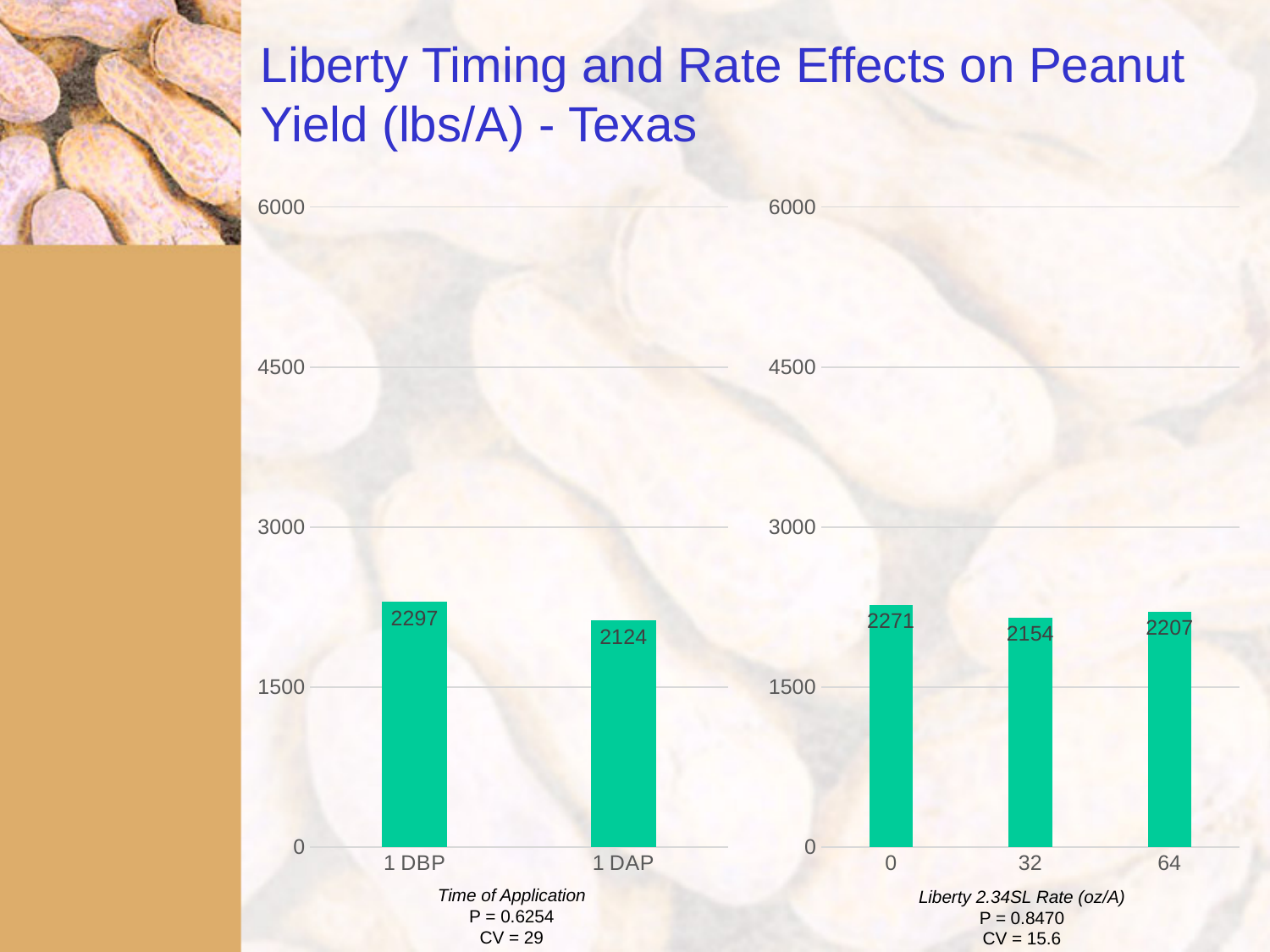
What kind of chart is the right chart (Liberty 2.34SL Rate)? bar chart In the right chart (Liberty 2.34SL Rate), what is the yield at the 64 oz/A rate? 2207 In the right chart (Liberty 2.34SL Rate), what is the difference between the yields at 0 and 64 oz/A? 64 In the left chart (Time of Application), what is the yield for 1 DAP? 2124 In the left chart (Time of Application), what is the difference between the 1 DBP and 1 DAP yields? 173 In the left chart (Time of Application), how many bars are plotted? 2 In the right chart (Liberty 2.34SL Rate), is the yield at 64 oz/A greater or less than 3000? less In the right chart (Liberty 2.34SL Rate), what is the yield at the 32 oz/A rate? 2154 In the left chart (Time of Application), what is the yield for 1 DBP? 2297 In the right chart (Liberty 2.34SL Rate), which rate has the lowest yield? 32 In the left chart (Time of Application), which application timing has the higher yield? 1 DBP In the right chart (Liberty 2.34SL Rate), what is the yield at the 0 oz/A rate? 2271